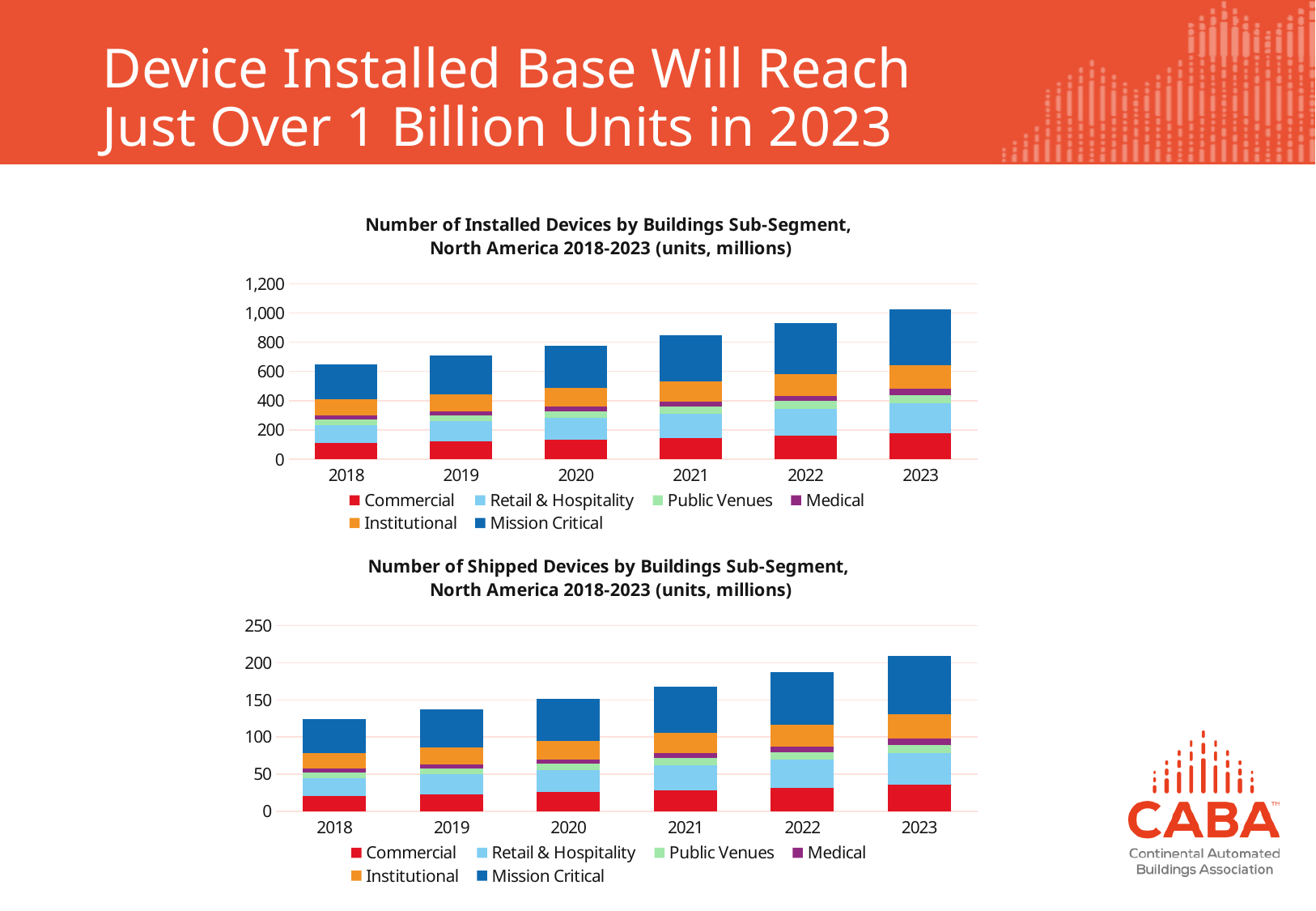
In the top chart (Number of Installed Devices), is the total for 2018 greater or less than 800? less In the top chart (Number of Installed Devices), how many series does the legend list? 6 In the top chart (Number of Installed Devices), do the total bar heights rise or fall from 2018 to 2023? rise In the top chart (Number of Installed Devices), what kind of chart is shown? Stacked bar chart In the bottom chart (Number of Shipped Devices), which series is shown in dark blue in the legend? Mission Critical In the bottom chart (Number of Shipped Devices), is the total for 2023 greater or less than 200? greater In the top chart (Number of Installed Devices), is the total for 2023 greater or less than 1,000? greater In the bottom chart (Number of Shipped Devices), which is larger, the total bar for 2022 or the total bar for 2019? 2022 In the top chart (Number of Installed Devices), which year has the tallest total bar? 2023 In the top chart (Number of Installed Devices), how many years are shown on the x axis? 6 In the top chart (Number of Installed Devices), which year has the shortest total bar? 2018